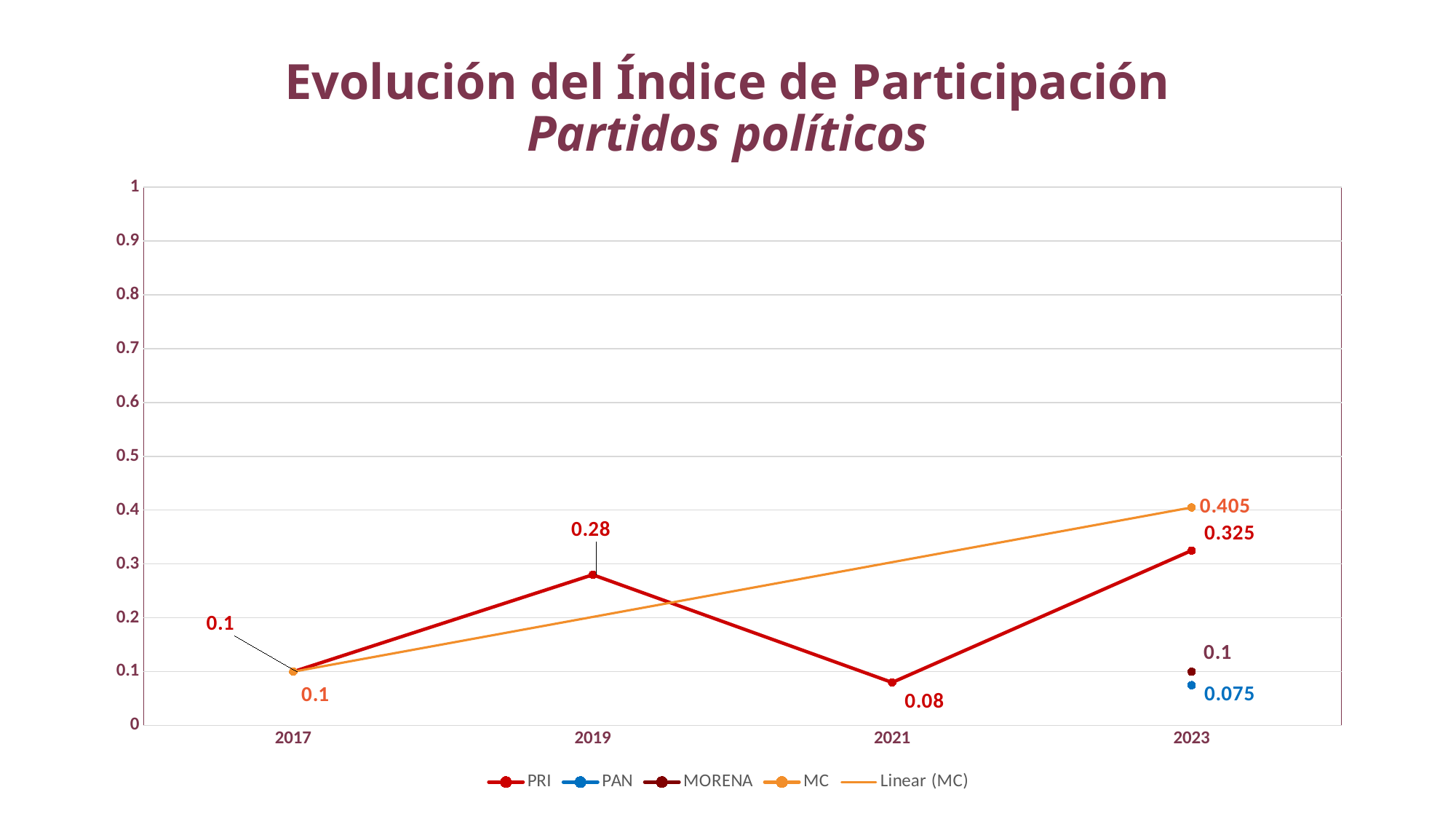
What is the value for PRI in 2019? 0.28 In which year does PRI have its lowest value? 2021 In which year does PRI have its highest value? 2023 What is the value for PAN in 2023? 0.075 How many years are shown on the x axis? 4 What kind of chart is shown on the slide? Line chart What is the difference between the MC value in 2023 and in 2017? 0.305 What is the value for PRI in 2023? 0.325 What is the value for MORENA in 2023? 0.1 What is the value for MC in 2023? 0.405 How many entries does the legend list? 5 In 2023, which is larger, the value for MC or the value for PRI? MC